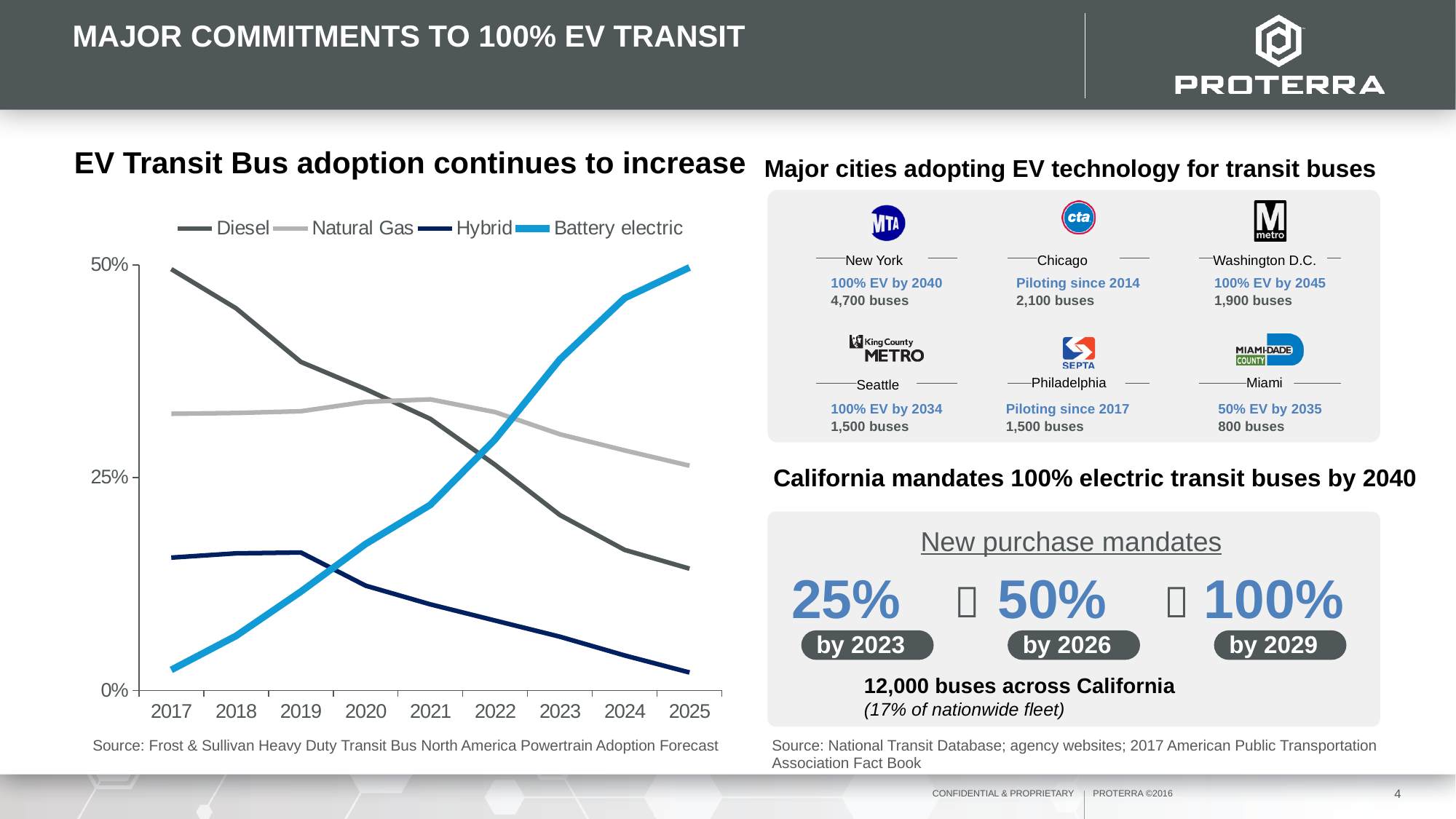
Which series has the highest value in 2025 in the line chart? Battery electric Does the Battery electric line rise or fall from 2017 to 2025? Rise Is the value for Battery electric in 2017 greater or less than 25%? less Which series has the lowest value in 2017 in the line chart? Battery electric Which series has the highest value in 2017 in the line chart? Diesel Which series has the lowest value in 2025 in the line chart? Hybrid How many years are shown on the x axis of the line chart? 9 How many series does the legend of the line chart list? 4 What kind of chart is shown under the heading 'EV Transit Bus adoption continues to increase'? Line chart In 2025, which is larger in the line chart: Diesel or Battery electric? Battery electric Which series in the line chart is drawn in light blue? Battery electric Does the Diesel line rise or fall from 2017 to 2025? Fall